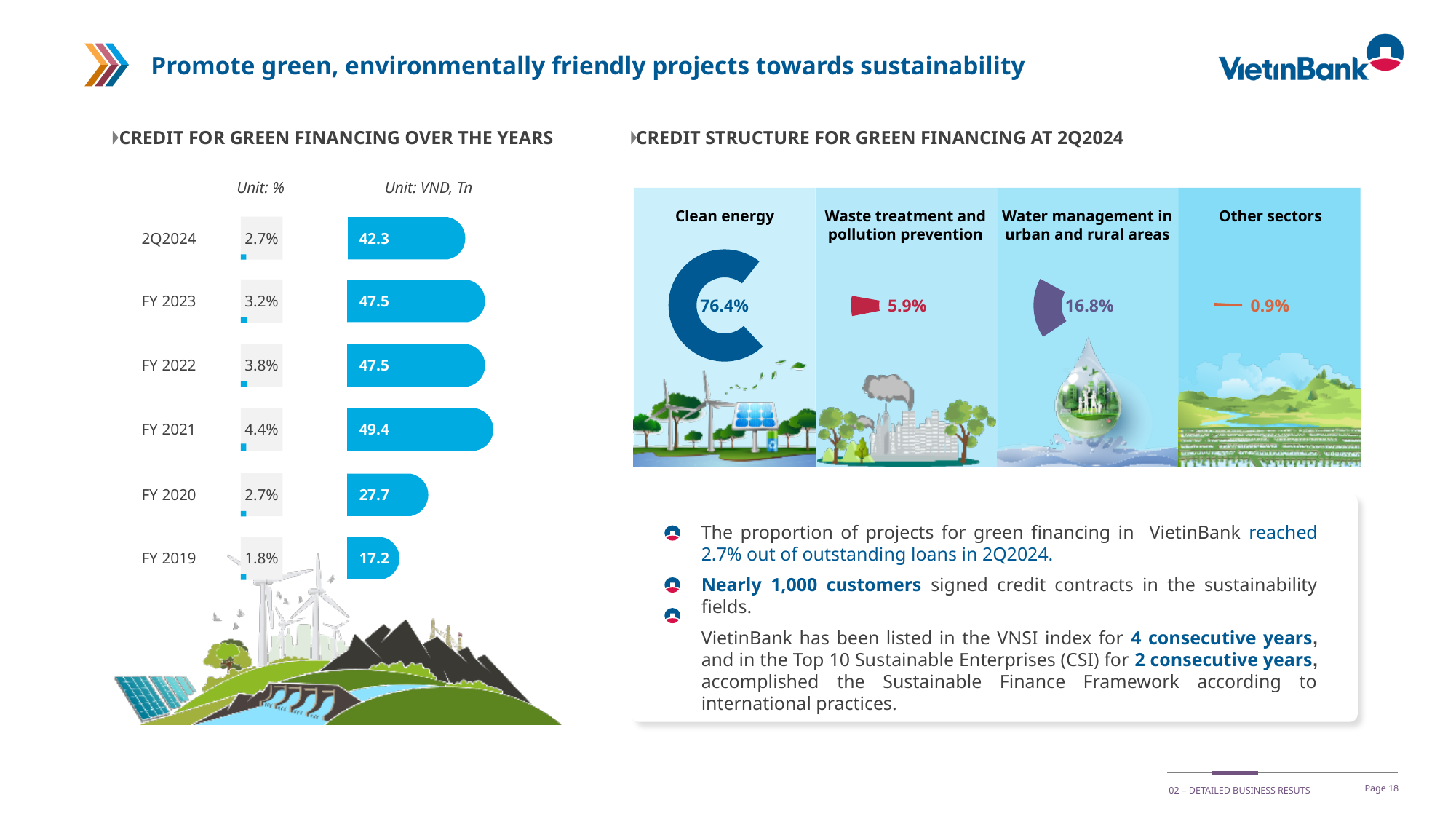
In the 'Credit for green financing over the years' chart, which period has the highest credit value in VND Tn? FY 2021 In the 'Credit structure for green financing at 2Q2024' chart, which sector has the smallest share? Other sectors In the 'Credit structure for green financing at 2Q2024' chart, how many sectors are shown? 4 In the 'Credit for green financing over the years' chart, what percentage is shown for FY 2021? 4.4% In the 'Credit structure for green financing at 2Q2024' chart, what is the difference between the shares of Water management in urban and rural areas and Waste treatment and pollution prevention? 10.9% In the 'Credit structure for green financing at 2Q2024' chart, what share does Clean energy have? 76.4% In the 'Credit for green financing over the years' chart, what is the difference in VND Tn between FY 2020 and FY 2019? 10.5 In the 'Credit for green financing over the years' chart, what is the credit value in VND Tn for 2Q2024? 42.3 In the 'Credit for green financing over the years' chart, is the VND Tn value for FY 2023 larger or smaller than for 2Q2024? larger In the 'Credit for green financing over the years' chart, how many periods are shown? 6 In the 'Credit for green financing over the years' chart, which period has the lowest credit value in VND Tn? FY 2019 In the 'Credit for green financing over the years' chart, what is the percentage shown for FY 2019? 1.8%